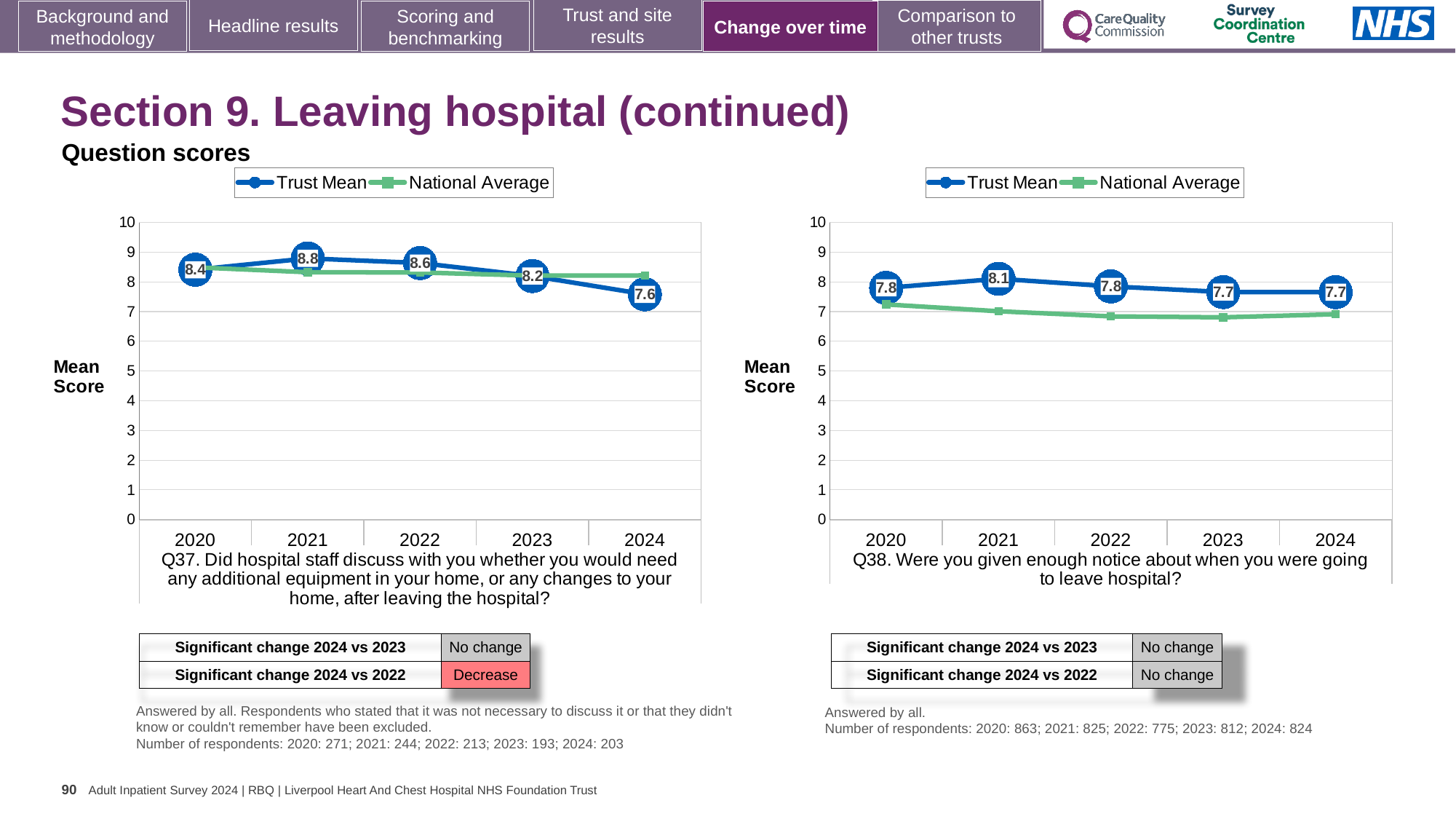
In the Q38 chart (right), is the Trust Mean for 2020 or 2021 higher? 2021 In the Q37 chart (left), which year has the lowest Trust Mean score? 2024 How many series does the legend of the Q37 chart (left) list? 2 How many years are shown on the x axis of the Q38 chart (right)? 5 In the Q37 chart (left), what is the difference between the Trust Mean scores for 2021 and 2024? 1.2 What type of chart is used for Q38 (right)? Line chart In the Q37 chart (left), what is the Trust Mean score for 2024? 7.6 In the Q37 chart (left), which year has the highest Trust Mean score? 2021 In the Q37 chart (left), what is the Trust Mean score for 2021? 8.8 In the Q38 chart (right), is the National Average value for 2022 greater or less than 7? less In the Q38 chart (right), what is the Trust Mean score for 2021? 8.1 In the Q38 chart (right), what is the difference between the Trust Mean scores for 2021 and 2023? 0.4